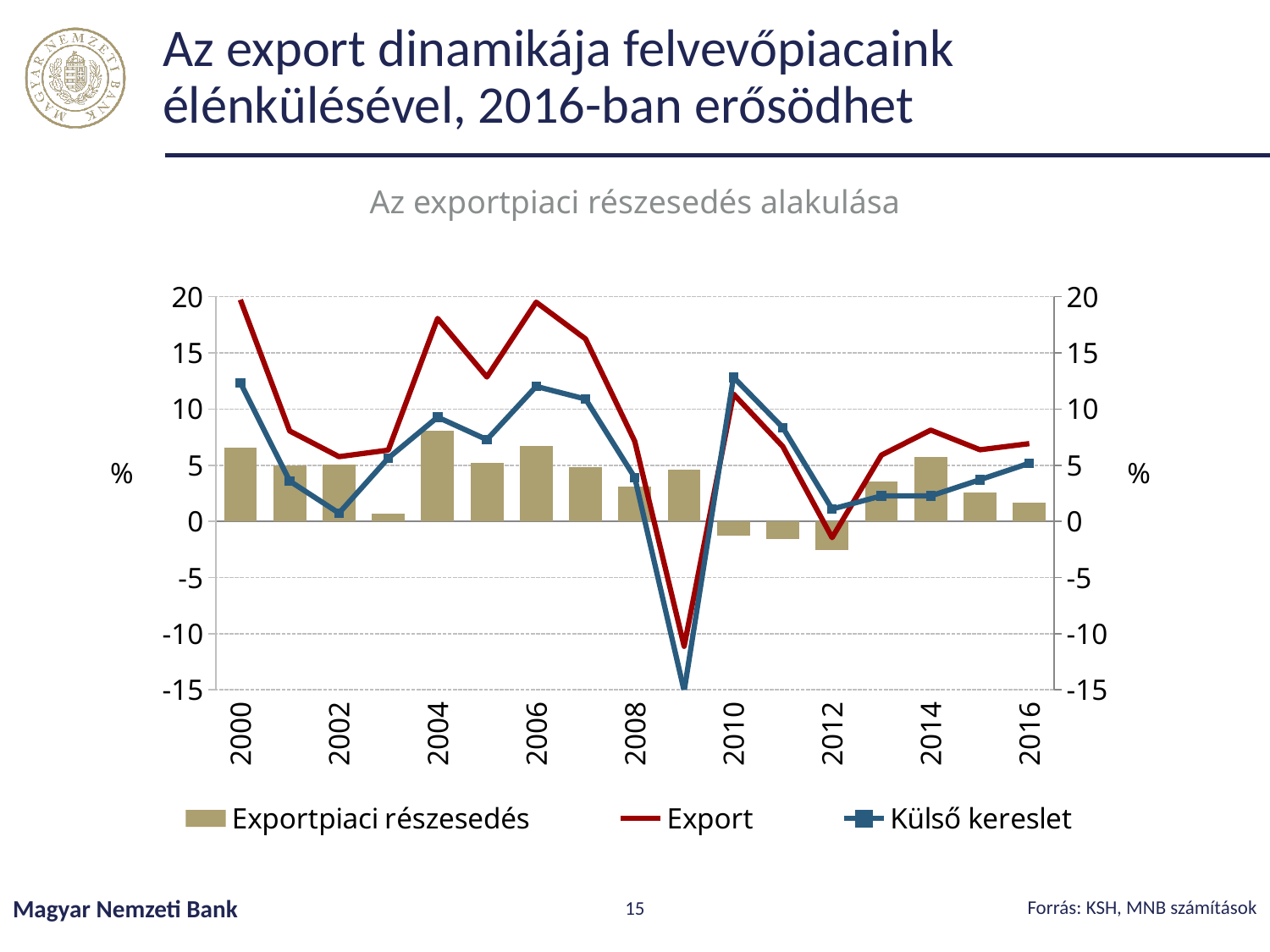
In which year does the Külső kereslet line reach its lowest value? 2009 In which year does the Export line reach its lowest value? 2009 How many years are plotted along the x axis? 17 Is the Exportpiaci részesedés bar for 2004 greater or less than 5? greater What kind of chart is shown on the slide? A combined bar and line chart Which is larger, the Exportpiaci részesedés bar for 2003 or for 2004? 2004 What is the title of the chart? Az exportpiaci részesedés alakulása Is the Exportpiaci részesedés bar for 2012 greater or less than 0? less Is the value of the Export line in 2009 greater or less than -10? less Does the Külső kereslet line rise or fall from 2012 to 2016? rise How many series does the legend list? 3